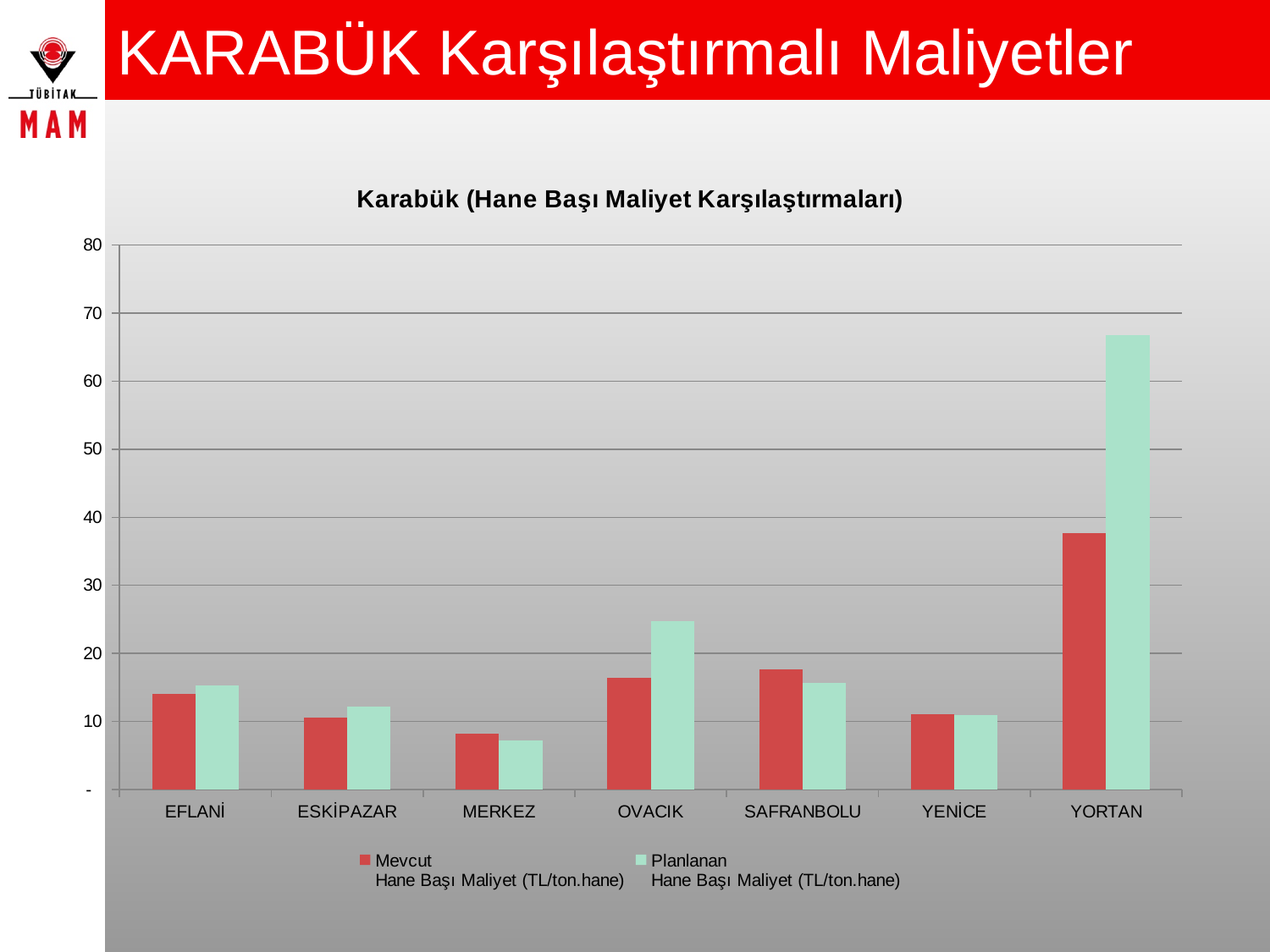
How many categories (districts) are shown on the x axis of the chart? 7 Which district has the lowest Planlanan Hane Başı Maliyet value? MERKEZ Which district has the highest Mevcut Hane Başı Maliyet value? YORTAN Which district has the highest Planlanan Hane Başı Maliyet value? YORTAN What kind of chart is shown on the slide? Bar chart For SAFRANBOLU, which is larger: the Mevcut or the Planlanan Hane Başı Maliyet value? Mevcut What is the title of the chart? Karabük (Hane Başı Maliyet Karşılaştırmaları) For OVACIK, which is larger: the Mevcut or the Planlanan Hane Başı Maliyet value? Planlanan Which district has the lowest Mevcut Hane Başı Maliyet value? MERKEZ Is the Planlanan Hane Başı Maliyet value for OVACIK greater or less than 20? greater Is the Planlanan Hane Başı Maliyet value for YORTAN greater or less than 60? greater How many series does the chart's legend list? 2